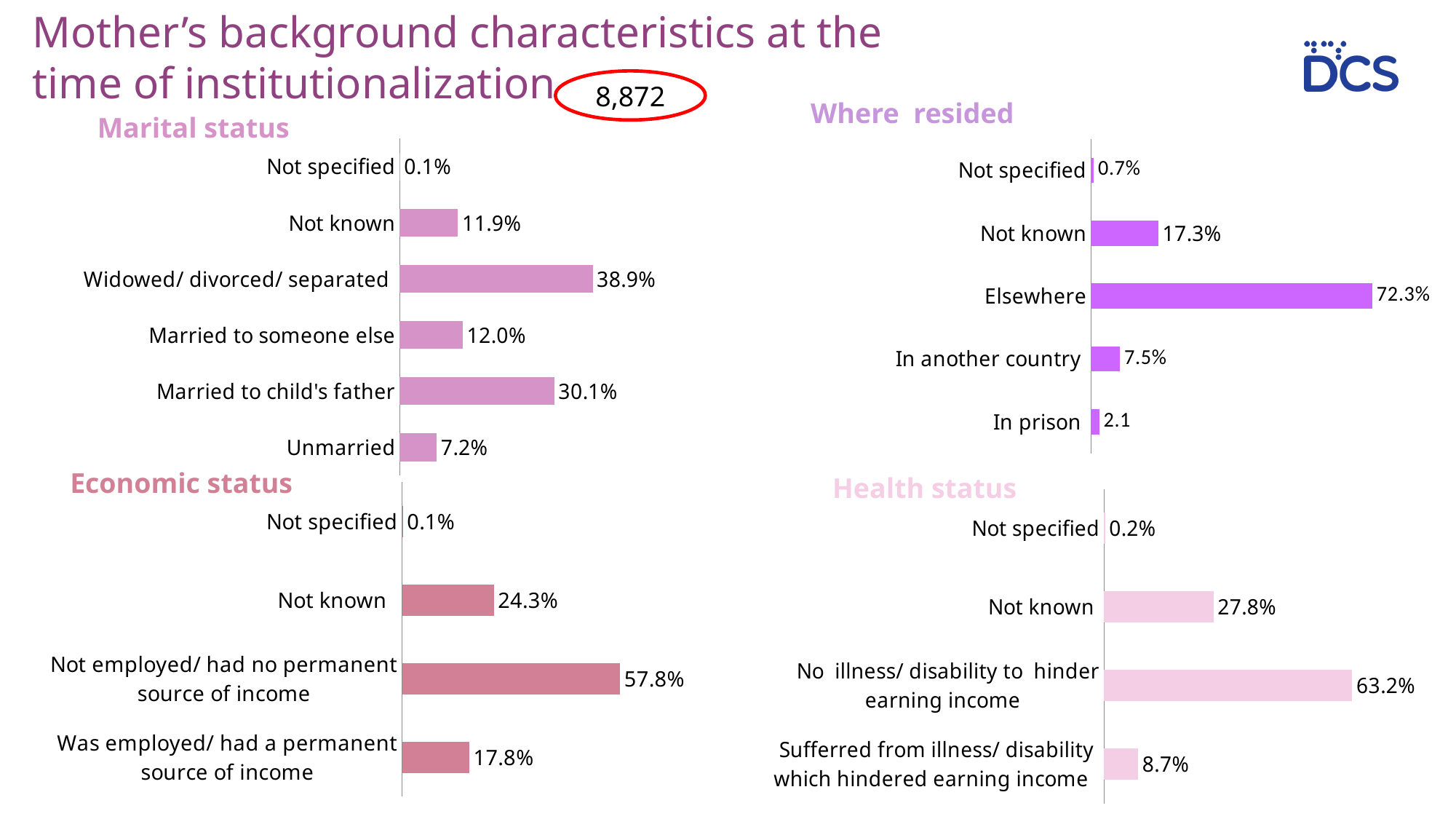
What kind of chart is the Marital status chart? Bar chart In the Where resided chart, which category has the highest value? Elsewhere In the Where resided chart, what is the value for Elsewhere? 72.3% How many categories are shown in the Marital status chart? 6 In the Marital status chart, what is the difference between Married to child's father and Married to someone else? 18.1% In the Economic status chart, what is the value for Not employed/ had no permanent source of income? 57.8% In the Health status chart, what is the value for Sufferred from illness/ disability which hindered earning income? 8.7% In the Marital status chart, what is the value for Widowed/ divorced/ separated? 38.9% In the Health status chart, what is the difference between No illness/ disability to hinder earning income and Not known? 35.4% In the Where resided chart, how many categories are shown? 5 In the Marital status chart, which category has the lowest value? Not specified In the Economic status chart, which is larger: Not known or Was employed/ had a permanent source of income? Not known